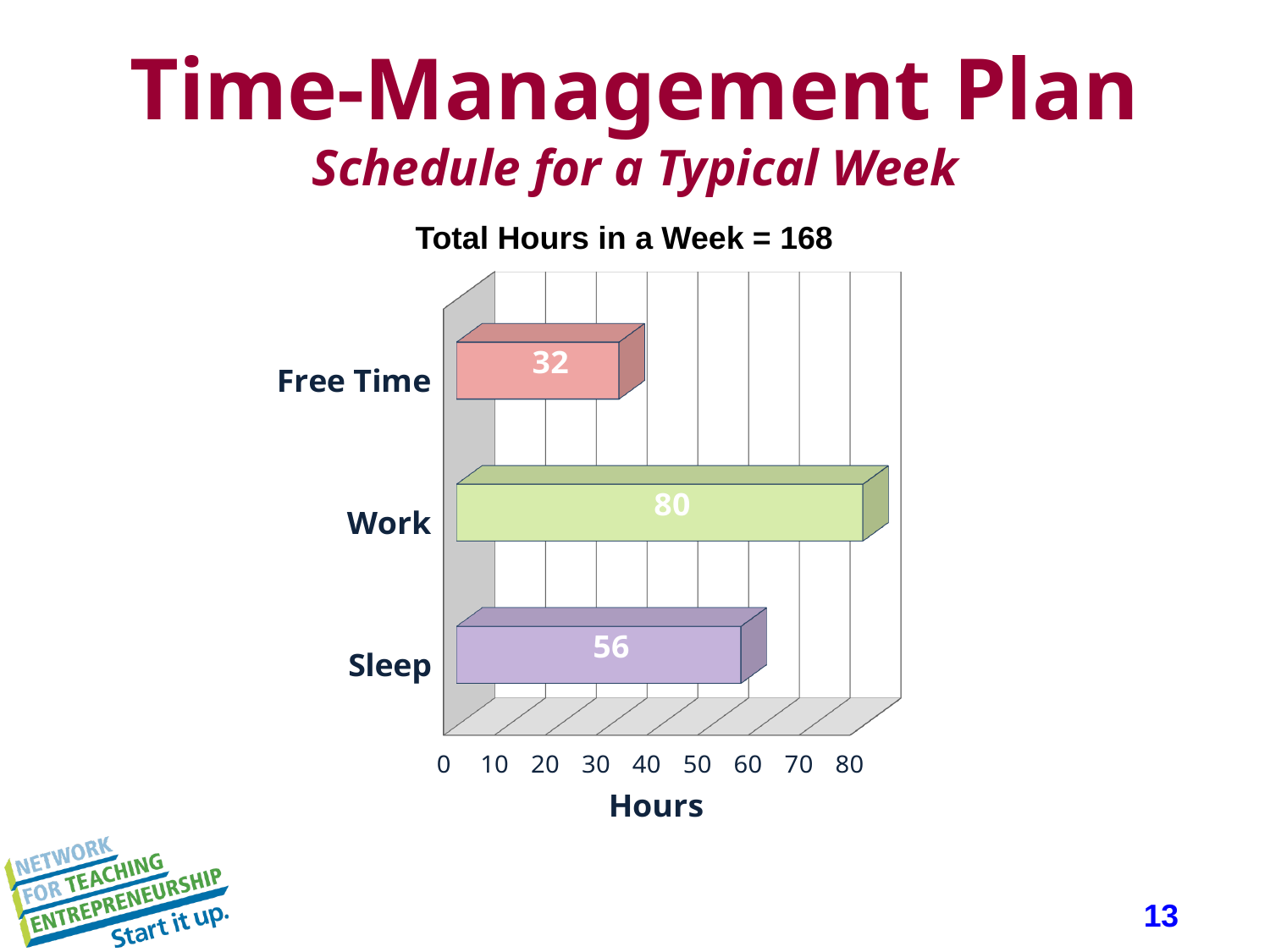
Which category has the lowest number of hours? Free Time What is the difference in hours between Work and Sleep? 24 What is the title of the chart? Total Hours in a Week = 168 Which category has the highest number of hours? Work What is the difference in hours between Sleep and Free Time? 24 What kind of chart is shown on the slide? Bar chart How many hours are shown for Sleep? 56 Which is larger, the hours for Sleep or the hours for Free Time? Sleep What is the label of the horizontal axis? Hours How many hours are shown for Work? 80 How many hours are shown for Free Time? 32 How many categories are plotted in the chart? 3